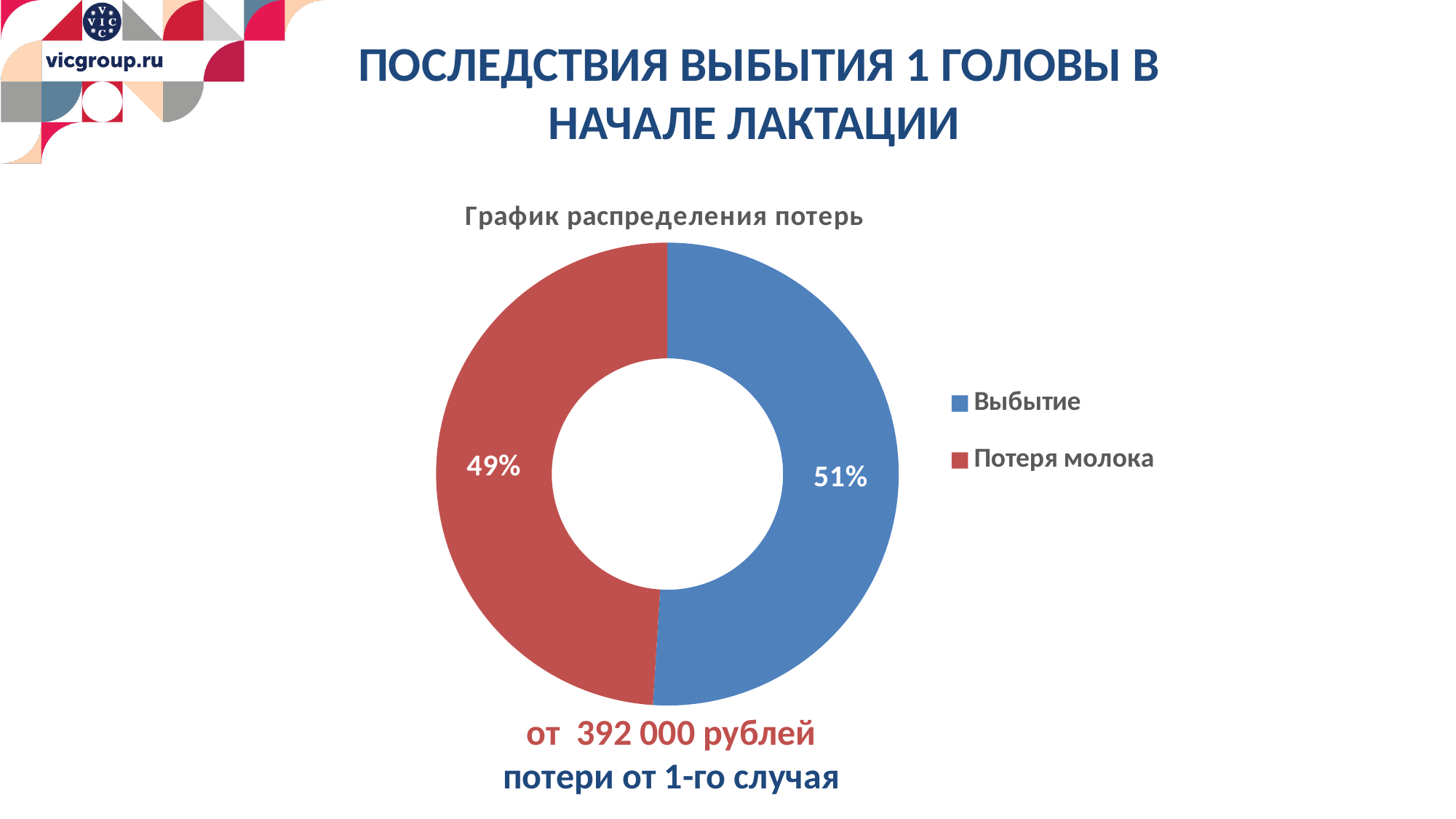
Which category has the smallest share in the chart? Потеря молока What kind of chart is shown on the slide? Doughnut (pie) chart Which colour represents Потеря молока in the chart? Red How many categories does the chart show? 2 What is the difference in percentage points between the shares of Выбытие and Потеря молока? 2 percentage points What share of the chart does Выбытие account for? 51% Is the share of Выбытие greater or less than 50%? greater Which category has the largest share in the chart? Выбытие Which is larger, the share of Выбытие or the share of Потеря молока? Выбытие What is the title of the chart? График распределения потерь What share of the chart does Потеря молока account for? 49%